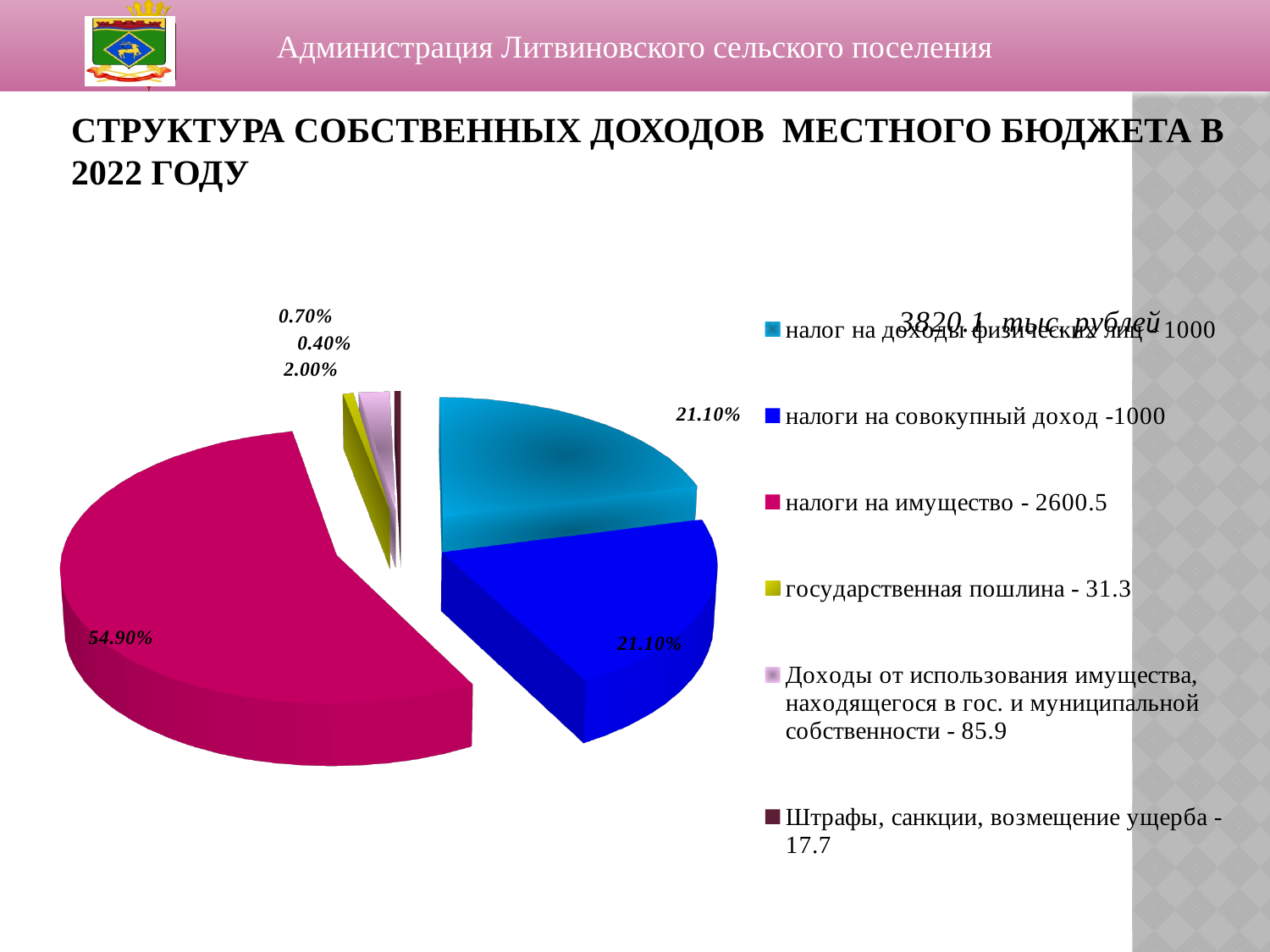
What value is given in the legend for налоги на имущество? 2600.5 Which category has the largest slice of the pie chart? налоги на имущество What value is given in the legend for налог на доходы физических лиц? 1000 What value is given in the legend for Штрафы, санкции, возмещение ущерба? 17.7 What share of the pie does налоги на имущество take? 54.90% What value is given in the legend for государственная пошлина? 31.3 Which category has the smallest value in the legend? Штрафы, санкции, возмещение ущерба How many categories does the legend of the pie chart list? 6 What kind of chart is shown on the slide? pie chart What colour is the slice for налоги на имущество? magenta (crimson) What value is given in the legend for Доходы от использования имущества, находящегося в гос. и муниципальной собственности? 85.9 What is the difference between the legend values for налоги на имущество and налоги на совокупный доход? 1600.5